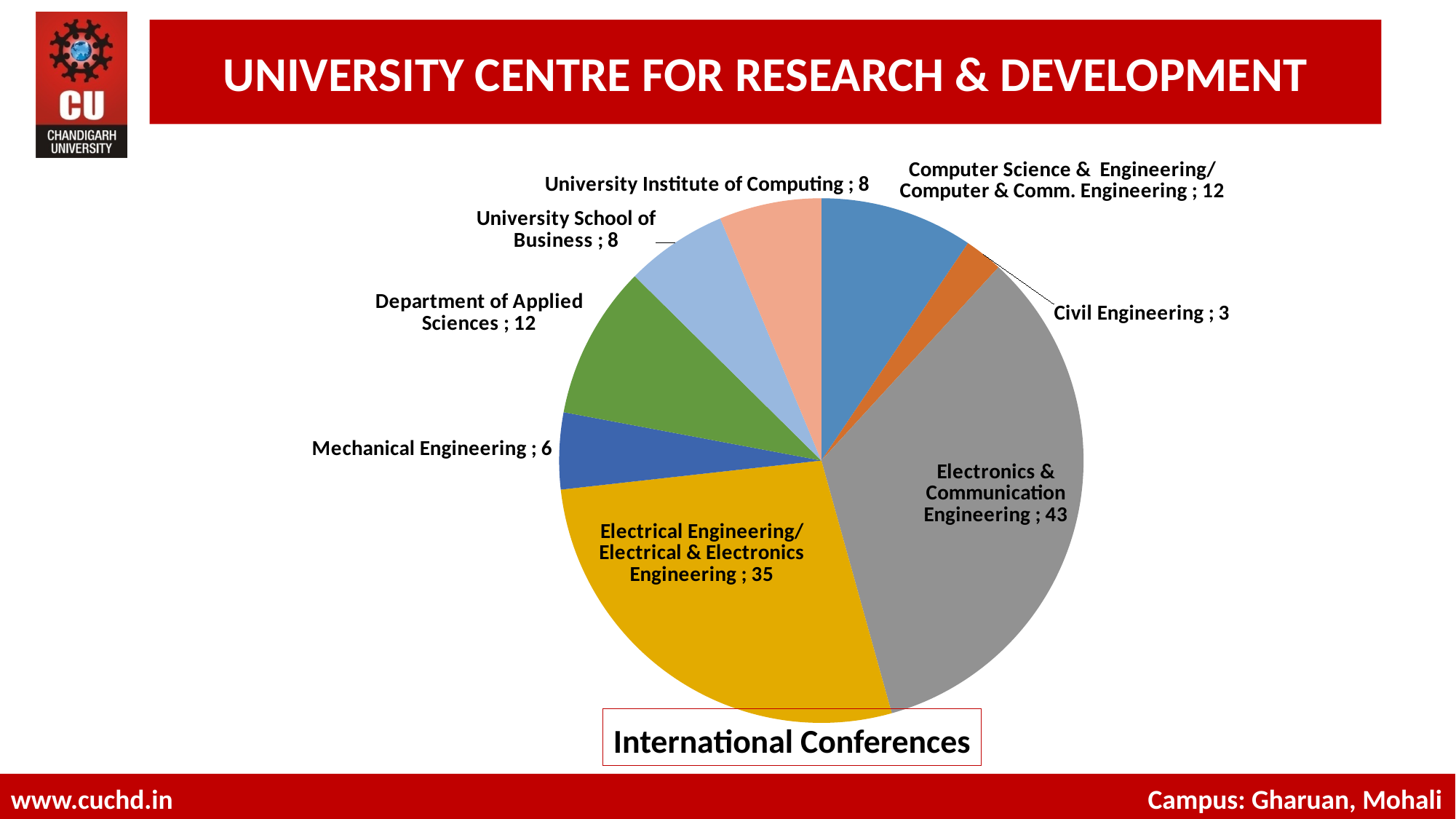
How many slices does the pie chart have? 8 What is the value for Mechanical Engineering? 6 What is the difference between the values for Electronics & Communication Engineering and Electrical Engineering/Electrical & Electronics Engineering? 8 What is the title shown below the pie chart? International Conferences What is the value for Department of Applied Sciences? 12 What is the total of all the values shown in the pie chart? 127 Which is larger, the value for University School of Business or the value for Mechanical Engineering? University School of Business Which department has the largest slice of the pie chart? Electronics & Communication Engineering What is the value for Civil Engineering in the pie chart? 3 How many international conferences are shown for Electronics & Communication Engineering? 43 Which department has the smallest slice of the pie chart? Civil Engineering What kind of chart is shown on the slide? Pie chart